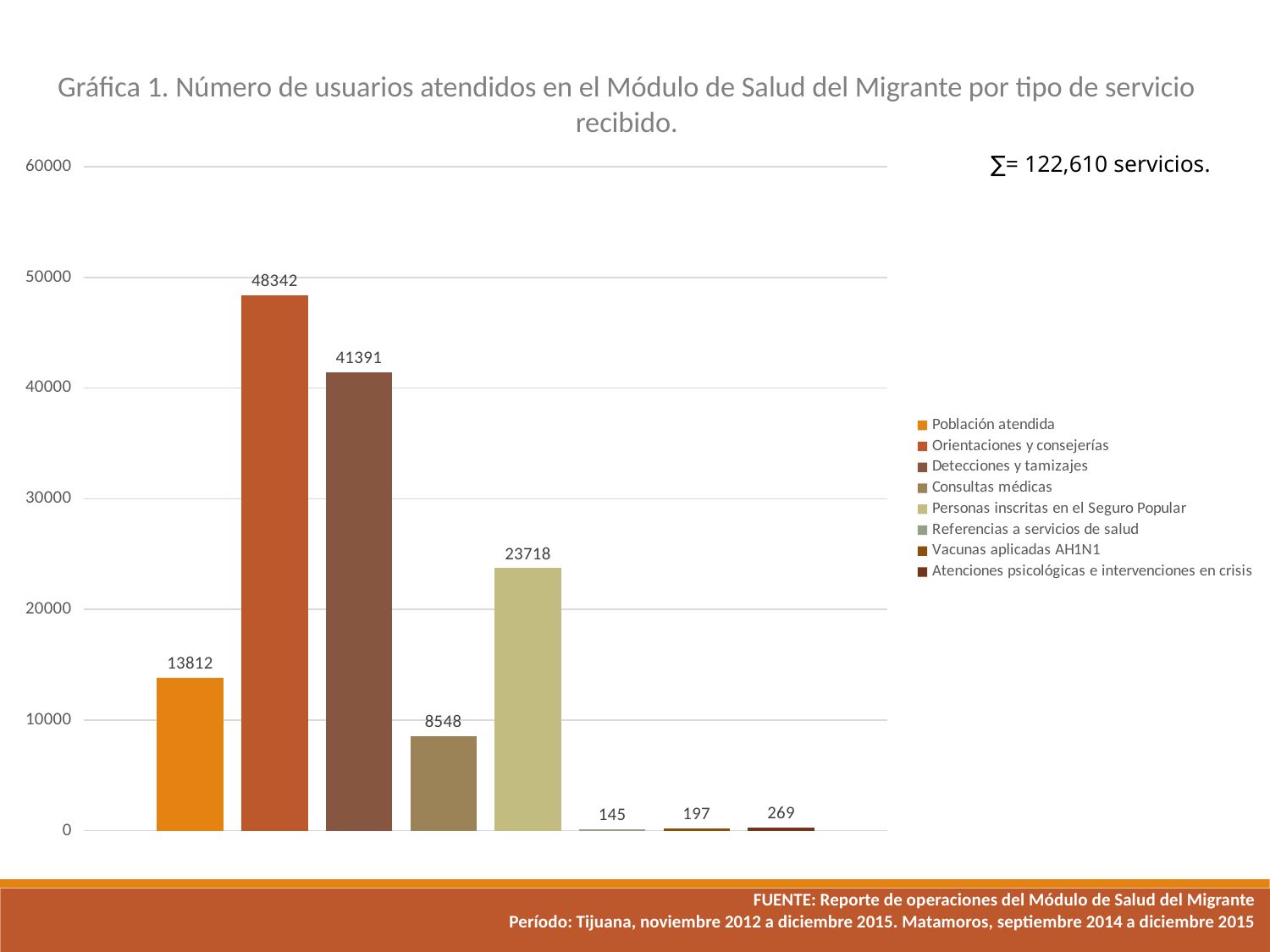
Which is larger, Población atendida or Consultas médicas? Población atendida Which service type has the lowest number of users? Referencias a servicios de salud What is the difference between Orientaciones y consejerías and Detecciones y tamizajes? 6951 What is the value for Vacunas aplicadas AH1N1? 197 What is the value for Personas inscritas en el Seguro Popular? 23718 What kind of chart is shown on the slide? bar chart Which service type has the highest number of users? Orientaciones y consejerías How many bars are plotted in the chart? 8 Is the value for Detecciones y tamizajes greater or less than 40000? greater How many series does the legend list? 8 What total number of services is stated on the slide? 122,610 servicios What is the value for Orientaciones y consejerías? 48342